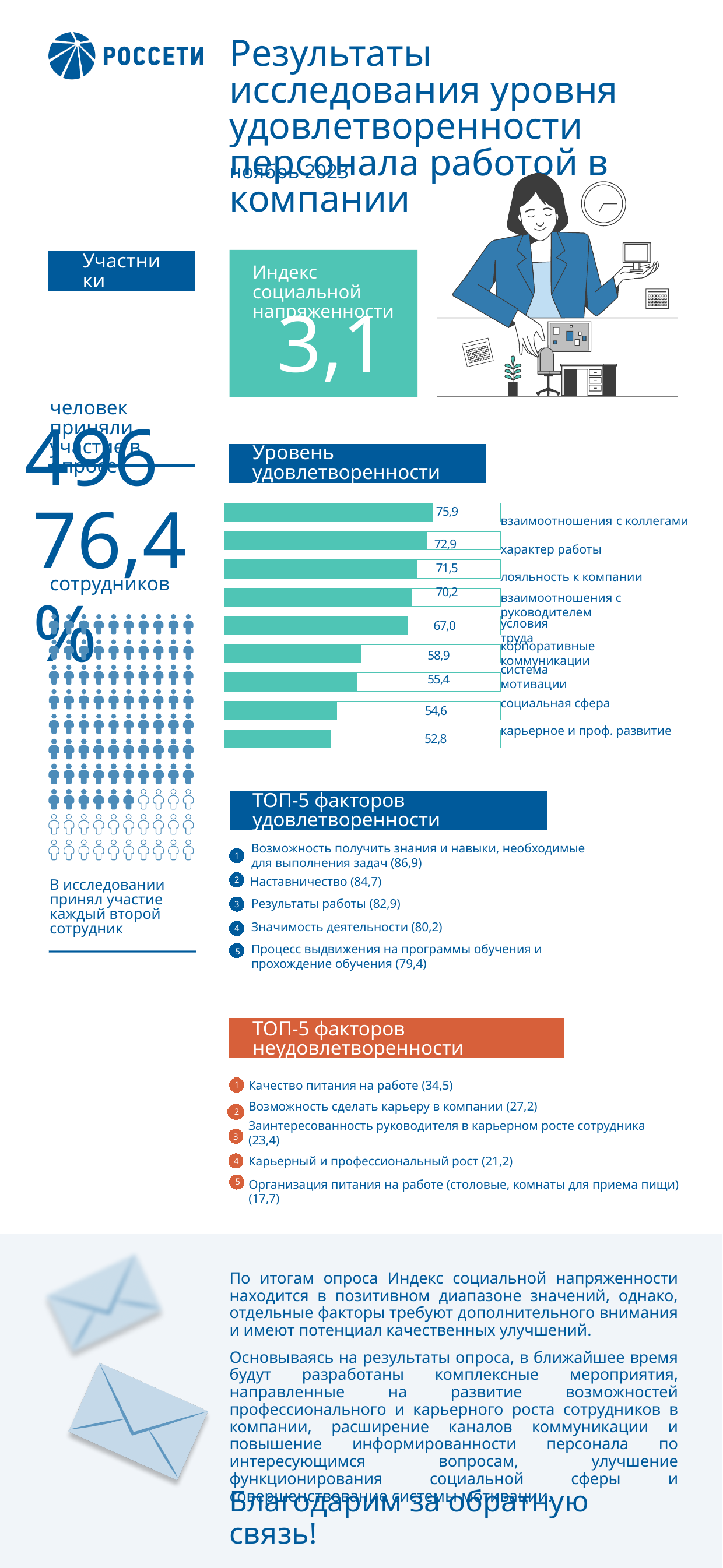
In the 'Уровень удовлетворенности' chart, which is larger: 'система мотивации' or 'социальная сфера'? система мотивации In the 'Уровень удовлетворенности' chart, what is the value for 'лояльность к компании'? 71,5 In the 'Уровень удовлетворенности' chart, what is the value for 'характер работы'? 72,9 In the 'Уровень удовлетворенности' chart, which category has the highest value? взаимоотношения с коллегами What type of chart is the 'Уровень удовлетворенности' chart? bar chart In the 'Уровень удовлетворенности' chart, what is the difference between 'взаимоотношения с коллегами' and 'карьерное и проф. развитие'? 23,1 In the 'Уровень удовлетворенности' chart, what is the value for 'карьерное и проф. развитие'? 52,8 How many categories are shown in the 'Уровень удовлетворенности' chart? 9 In the 'Уровень удовлетворенности' chart, what is the value for 'взаимоотношения с коллегами'? 75,9 In the 'Уровень удовлетворенности' chart, which category has the lowest value? карьерное и проф. развитие In the 'Уровень удовлетворенности' chart, what is the difference between 'корпоративные коммуникации' and 'система мотивации'? 3,5 In the 'Уровень удовлетворенности' chart, what is the value for 'условия труда'? 67,0